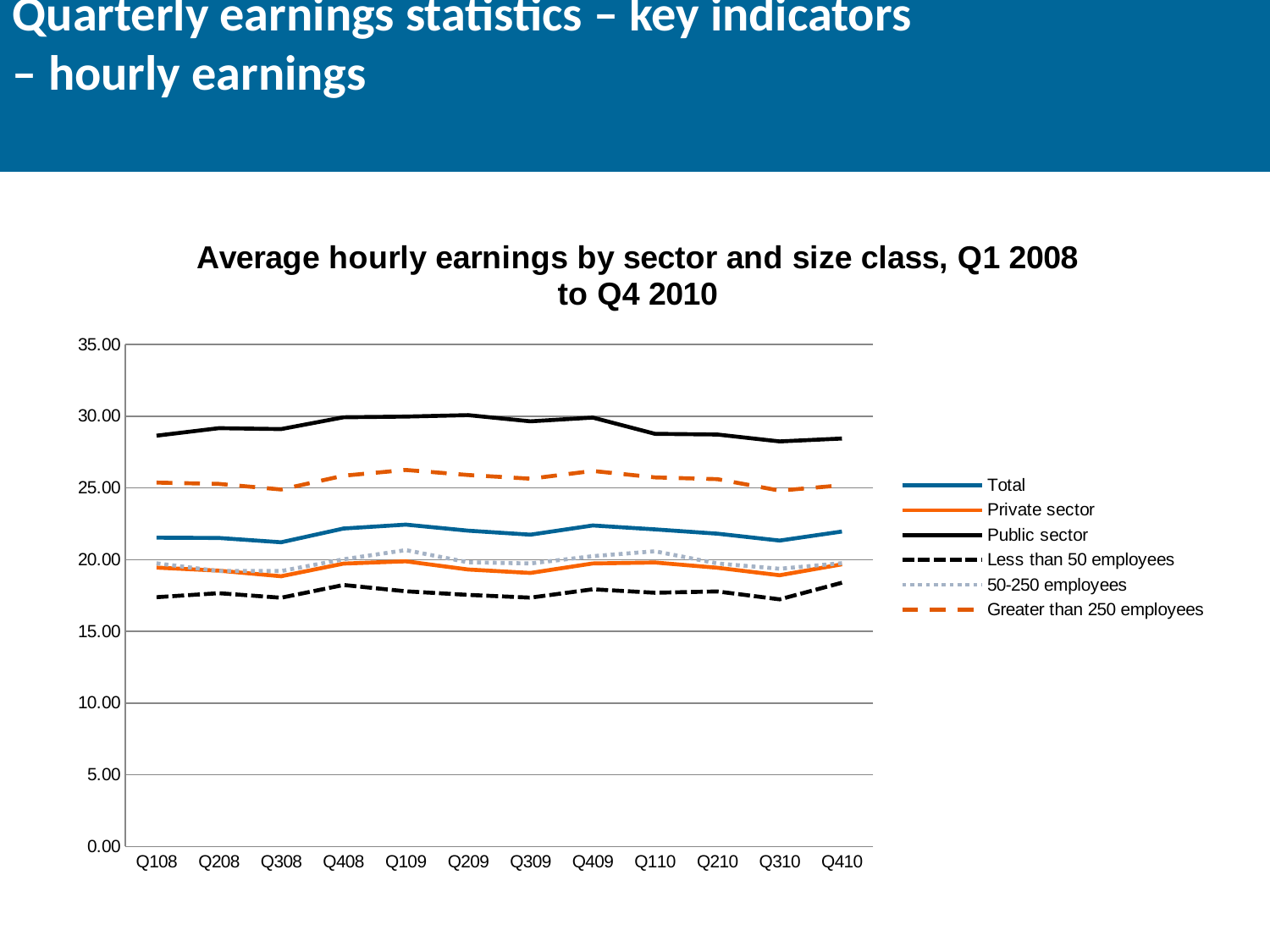
Which series has the highest average hourly earnings across all quarters? Public sector What kind of chart is shown on the slide? line chart Which series has the lowest average hourly earnings across all quarters? Less than 50 employees Is the value for Total in Q310 greater or less than 20.00? greater How many series does the legend list? 6 Is the value for Less than 50 employees in Q108 greater or less than 20.00? less What is the title of the chart? Average hourly earnings by sector and size class, Q1 2008 to Q4 2010 How many quarters are shown along the x axis? 12 Is the value for Public sector in Q109 greater or less than 25.00? greater In Q108, which is larger: Greater than 250 employees or Total? Greater than 250 employees In Q409, which is larger: Public sector or Private sector? Public sector